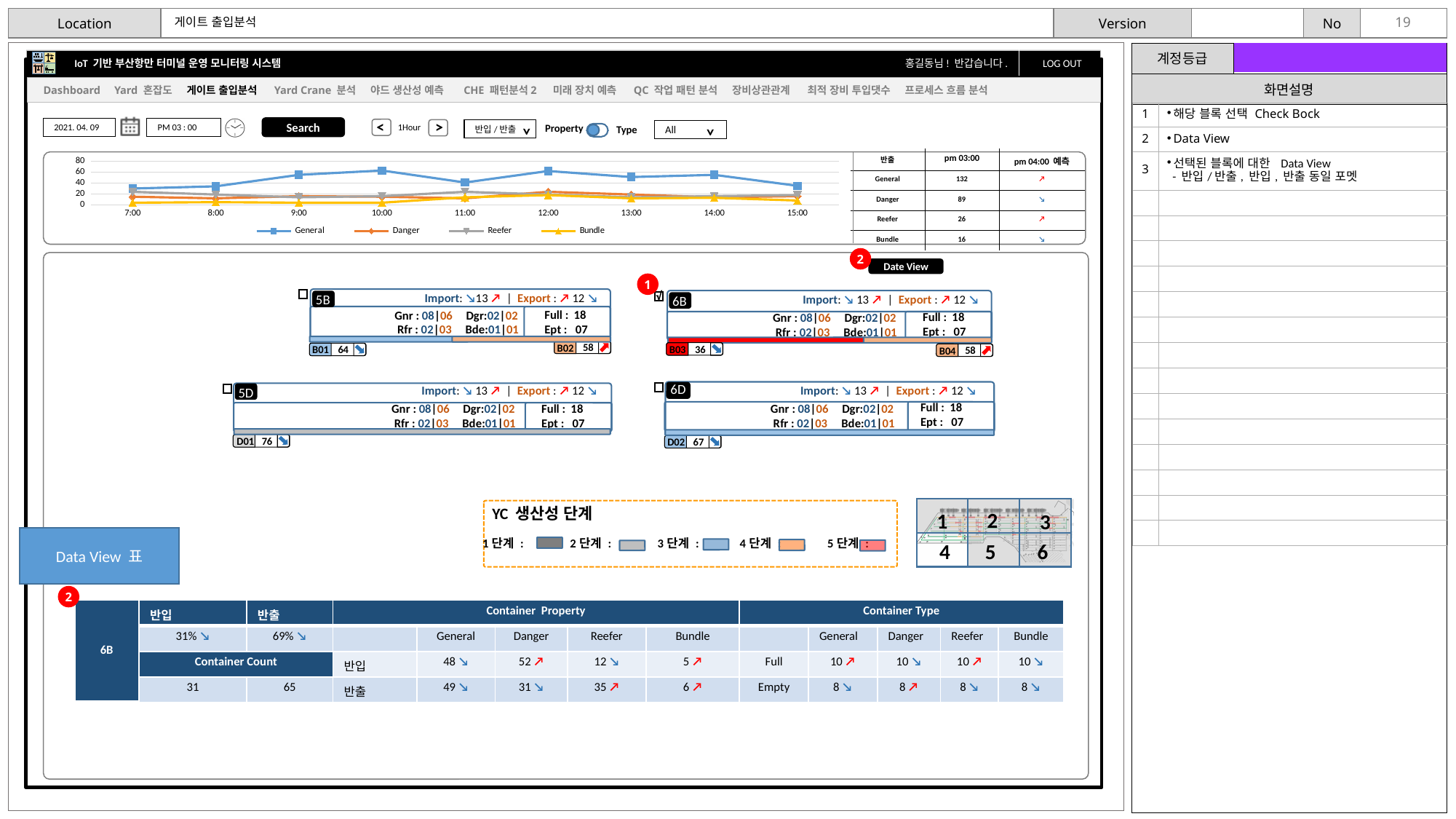
In the top line chart, does the General series rise or fall from 14:00 to 15:00? fall In the top line chart, is the value for General at 9:00 greater or less than 40? greater In the top line chart, which is larger at 10:00, General or Bundle? General Which series has the highest values across the top line chart? General In the top line chart, does the General series rise or fall from 7:00 to 9:00? rise How many series does the legend of the top line chart list? 4 What colour is the General series in the top line chart? blue What kind of chart is shown at the top of the slide? line chart How many time points are shown along the x axis of the top line chart? 9 In the top line chart, is the value for Bundle at 7:00 greater or less than 20? less In the top line chart, is the value for General at 7:00 greater or less than 40? less